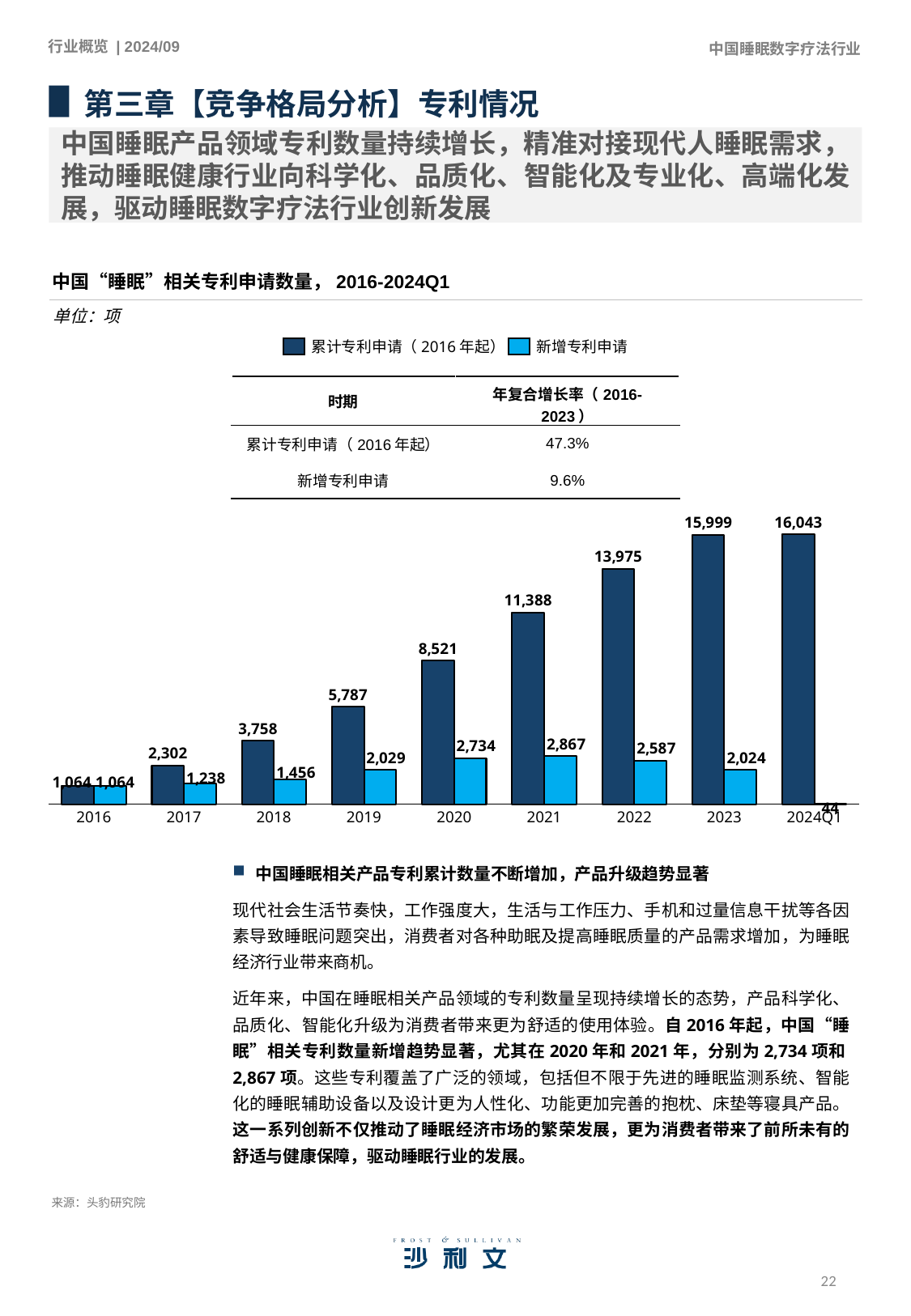
What is the value of 累计专利申请（2016年起） for 2020? 8,521 What is the difference between 累计专利申请（2016年起） in 2023 and in 2022? 2,024 What is the value of 新增专利申请 for 2021? 2,867 How many time periods are shown on the x axis of the chart? 9 Which is larger, 新增专利申请 in 2020 or in 2022? 2020 In which period is 新增专利申请 the lowest? 2024Q1 According to the table on the chart, what is the 年复合增长率（2016-2023） for 新增专利申请? 9.6% What is the value of 新增专利申请 for 2024Q1? 44 How many series does the chart legend list? 2 What type of chart is shown on the slide? bar chart Does 累计专利申请（2016年起） rise or fall from 2016 to 2024Q1? rise In which period is 新增专利申请 the highest? 2021